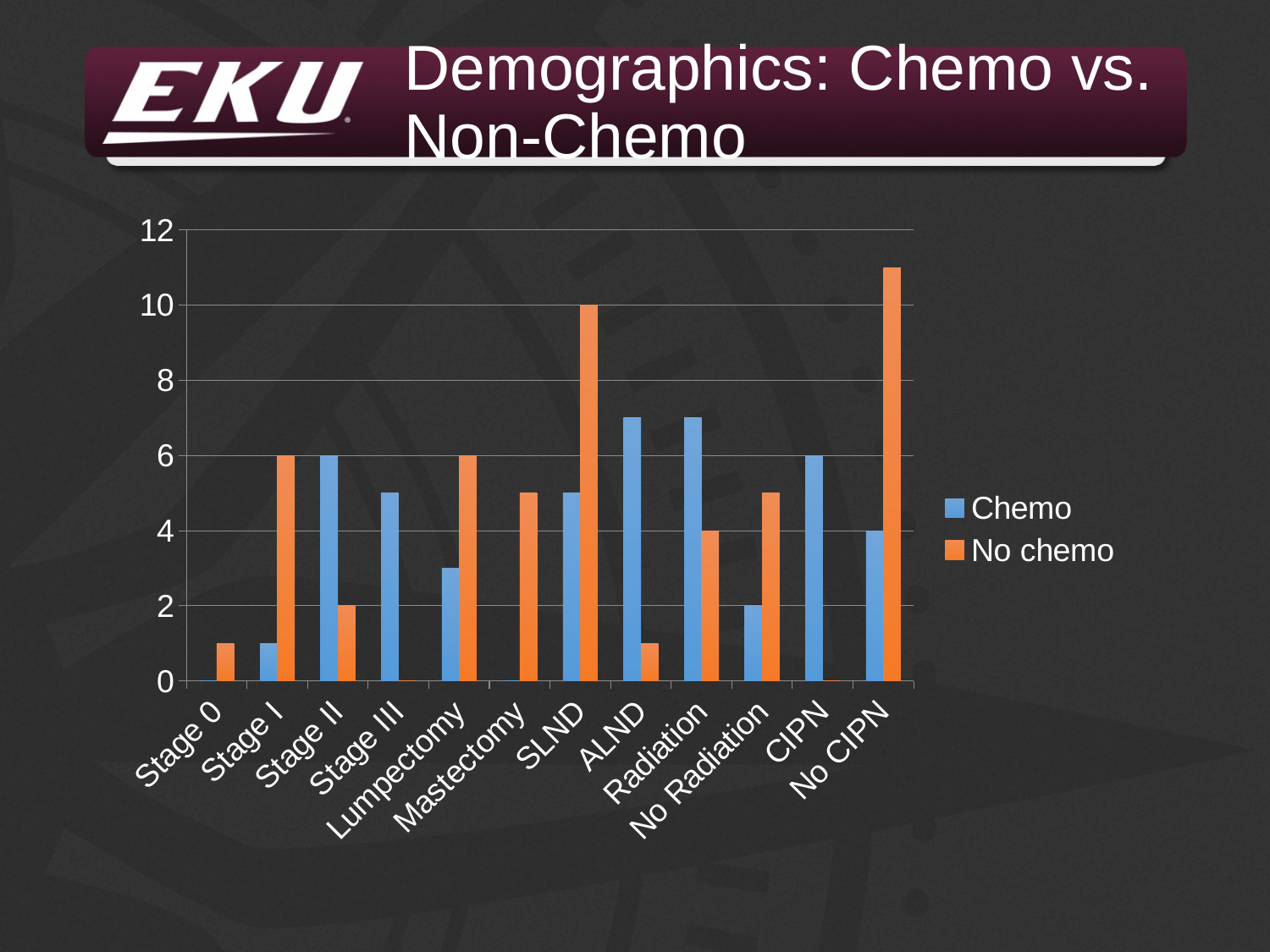
Is the Chemo value for ALND greater or less than 6? greater How many series does the legend list? 2 Is the No chemo value for No CIPN greater or less than 10? greater What is the No chemo value for Radiation? 4 What is the Chemo value for No CIPN? 4 What is the No chemo value for SLND? 10 How many categories are shown along the x axis? 12 What kind of chart is shown on the slide? Bar chart What is the difference between the Chemo and No chemo values for Stage II? 4 Which category has the highest No chemo value? No CIPN For SLND, which is larger: the Chemo value or the No chemo value? No chemo What is the Chemo value for Stage II? 6